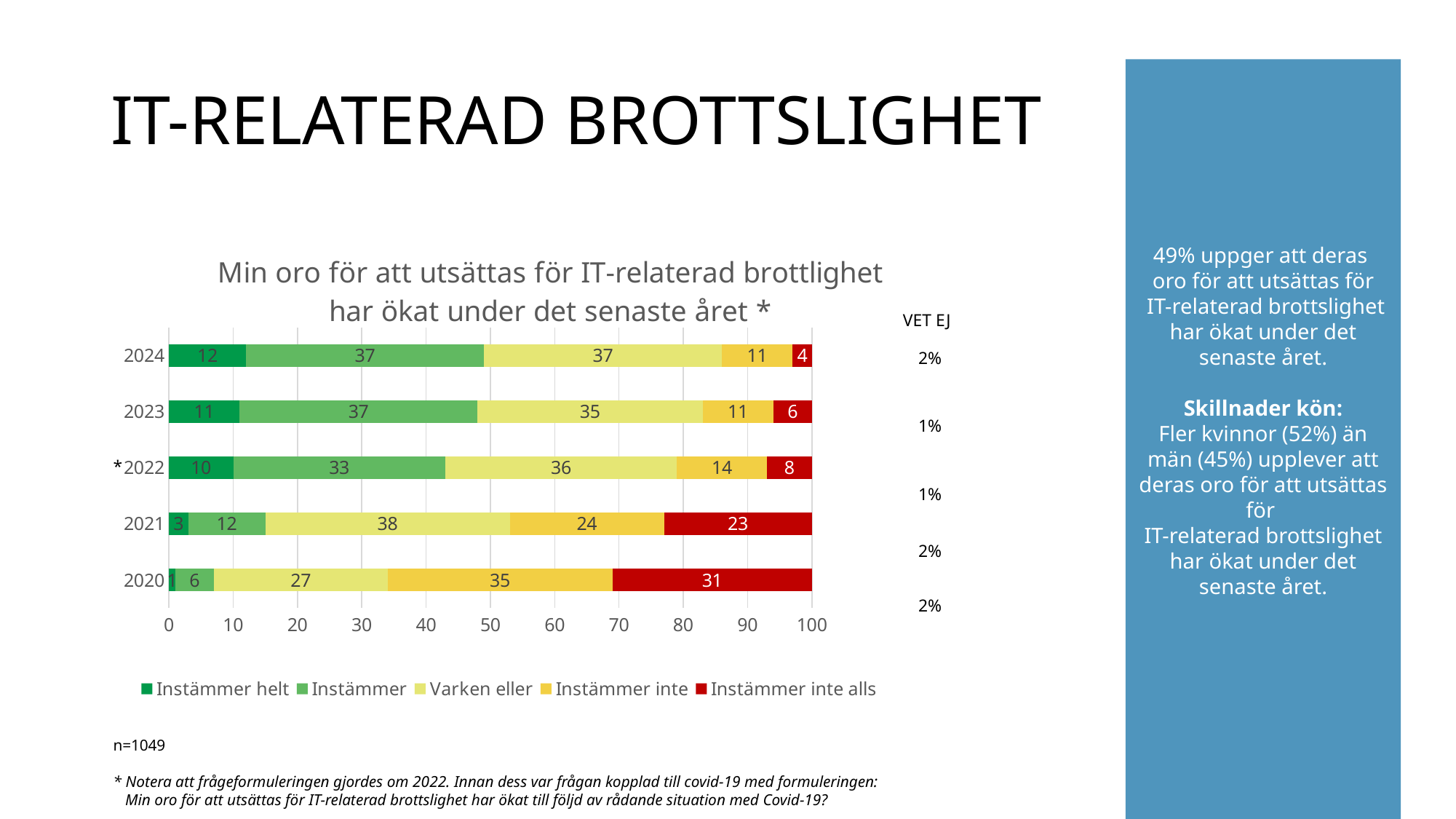
What is the difference between the "Instämmer inte alls" values for 2021 and 2024? 19 How many series does the legend list? 5 What is the value for "Instämmer inte" in 2022? 14 Does the "Instämmer inte alls" value rise or fall from 2020 to 2024? Fall How many years are shown on the chart? 5 What is the value for "Instämmer inte alls" in 2020? 31 What kind of chart is shown on the slide? Stacked bar chart Which is larger: the "Varken eller" value for 2021 or for 2020? 2021 Which year has the lowest value for "Instämmer helt"? 2020 What is the "VET EJ" value shown for 2024? 2% What is the value for "Instämmer" in 2024? 37 Which year has the highest value for "Instämmer inte alls"? 2020